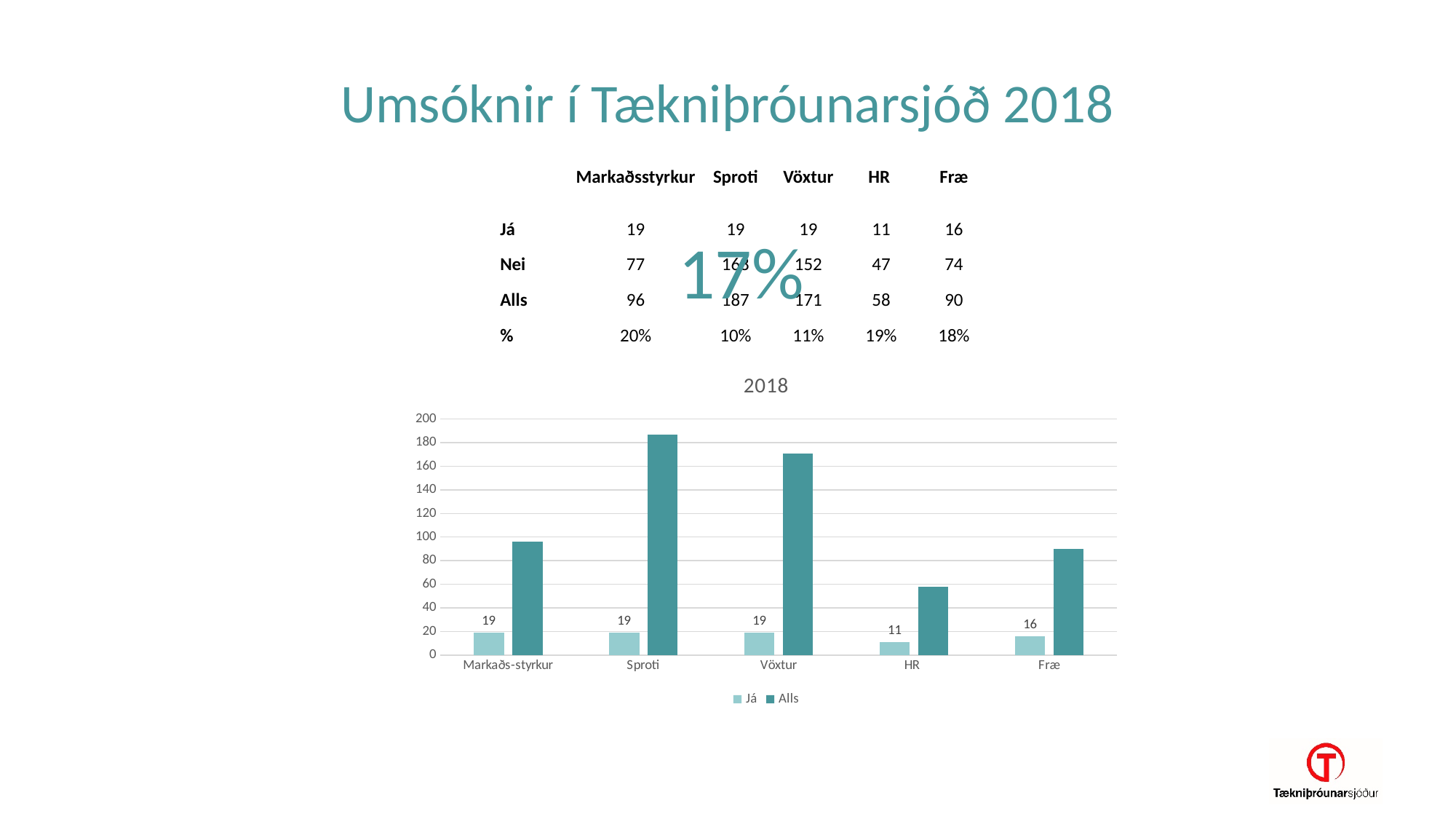
Which has the larger Alls bar, Vöxtur or Fræ? Vöxtur Is the Alls value for Sproti greater or less than 180? greater Which category has the lowest Alls bar? HR Which category has the highest Alls bar? Sproti How many series does the chart legend list? 2 Which category has the lowest Já value? HR Is the Alls value for HR greater or less than 60? less How many categories are shown on the x axis of the chart? 5 What is the value of the Já series for Fræ? 16 What kind of chart is shown on the slide? bar chart What is the value of the Já series for HR? 11 What is the difference between the Já value for Markaðs-styrkur and the Já value for HR? 8